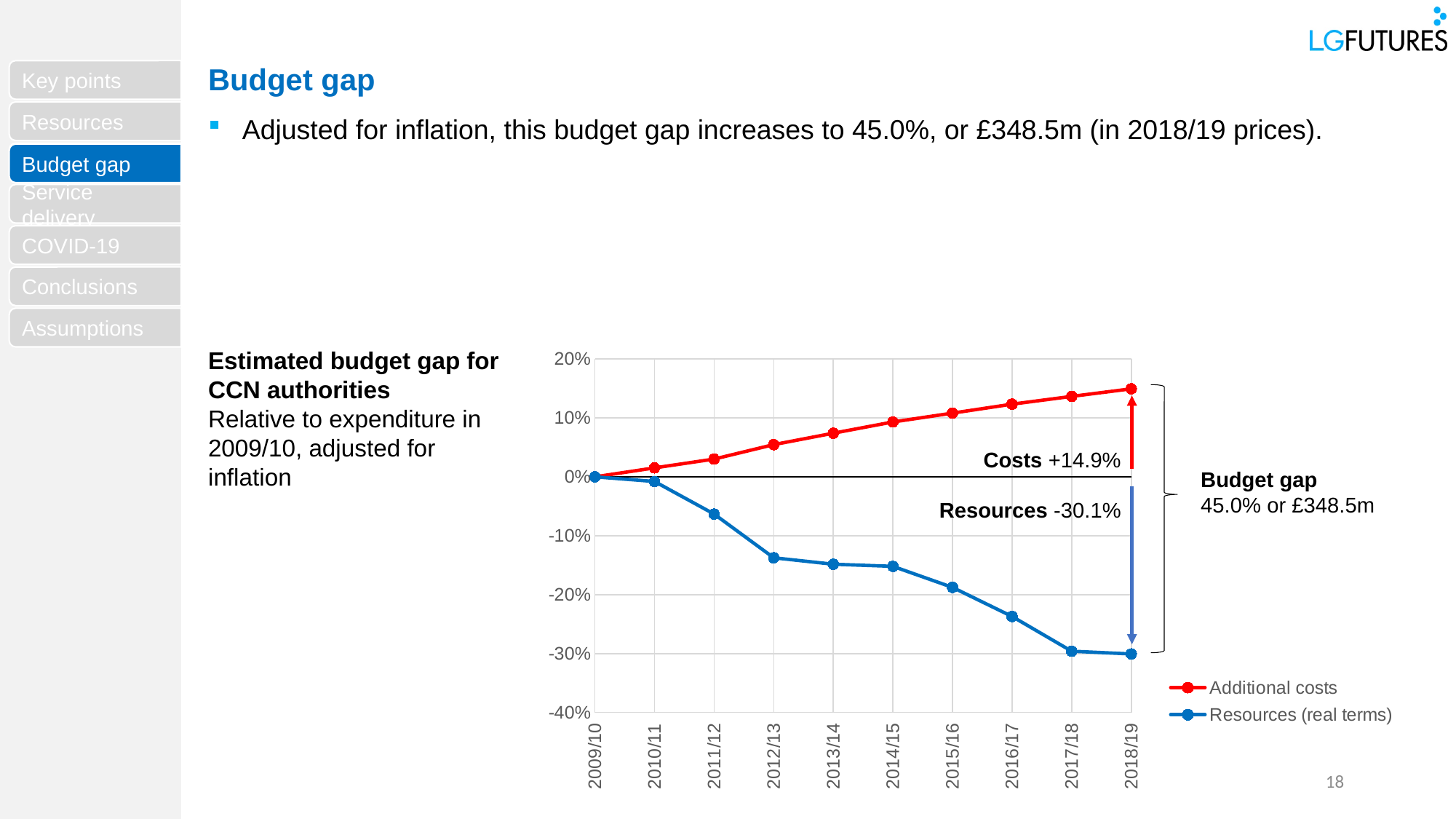
What type of chart is shown on the slide? line chart In which year is the Resources (real terms) series at its lowest? 2018/19 What is the value of Additional costs in 2018/19 according to the annotation on the chart? +14.9% How many years are shown on the x axis of the chart? 10 Does the Resources (real terms) series rise or fall from 2009/10 to 2018/19? fall Which colour is used for the Additional costs series? red Is the value for Resources (real terms) in 2012/13 greater or less than -10%? less What is the budget gap shown on the chart for 2018/19? 45.0% or £348.5m How many series does the legend list? 2 What is the value of Resources (real terms) in 2018/19 according to the annotation on the chart? -30.1% Does the Additional costs series rise or fall from 2009/10 to 2018/19? rise